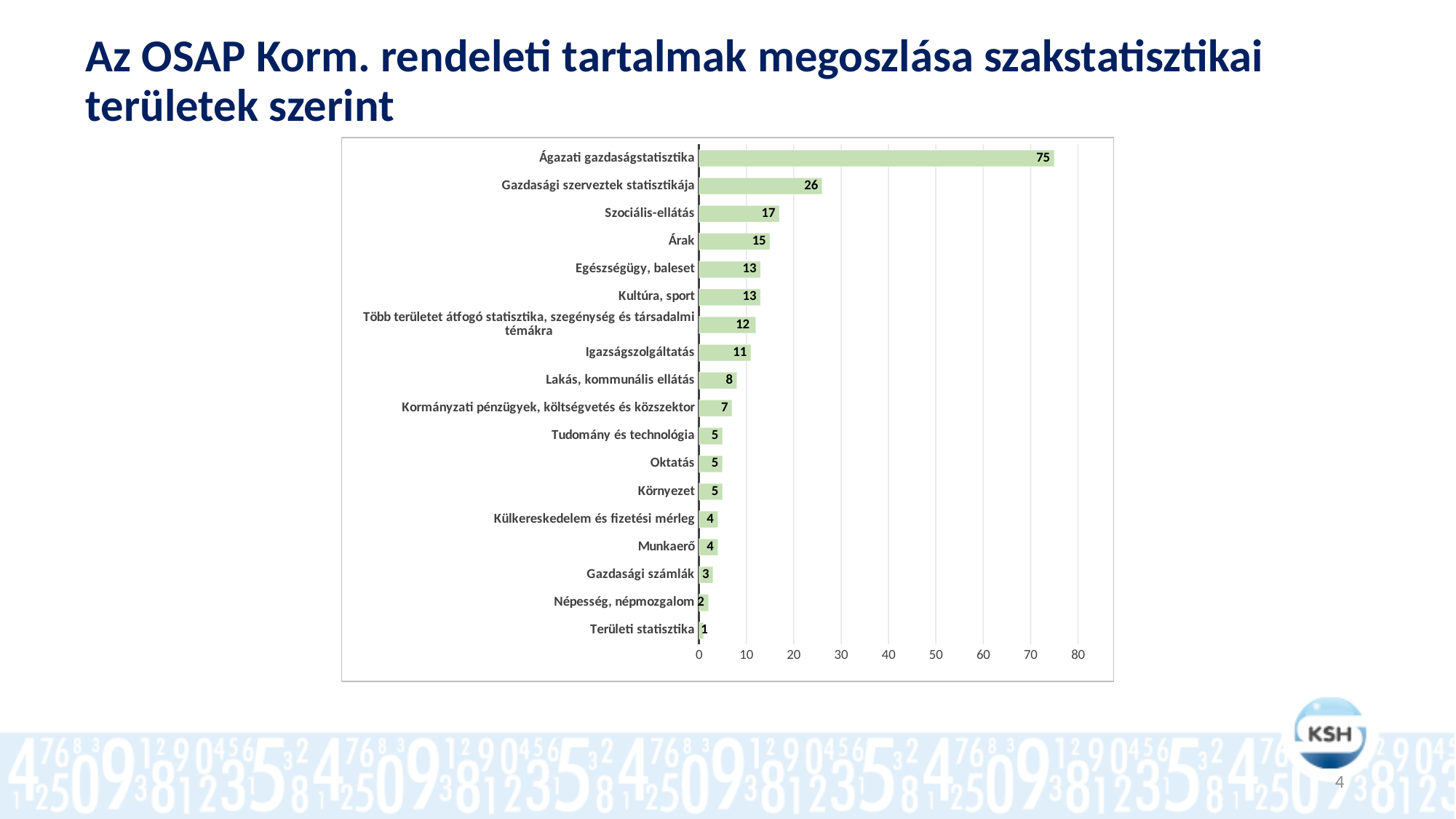
What is the value for Ágazati gazdaságstatisztika? 75 What is the value for Igazságszolgáltatás? 11 What is the difference between the values for Ágazati gazdaságstatisztika and Gazdasági szerveztek statisztikája? 49 What kind of chart is shown on the slide? bar chart Which category has the highest value? Ágazati gazdaságstatisztika Which category has the lowest value? Területi statisztika Is the value for Gazdasági szerveztek statisztikája greater or less than 20? greater What is the value for Munkaerő? 4 What is the difference between the values for Árak and Lakás, kommunális ellátás? 7 What is the value for Szociális-ellátás? 17 Which is larger, the value for Szociális-ellátás or the value for Kormányzati pénzügyek, költségvetés és közszektor? Szociális-ellátás How many categories are shown in the chart? 18